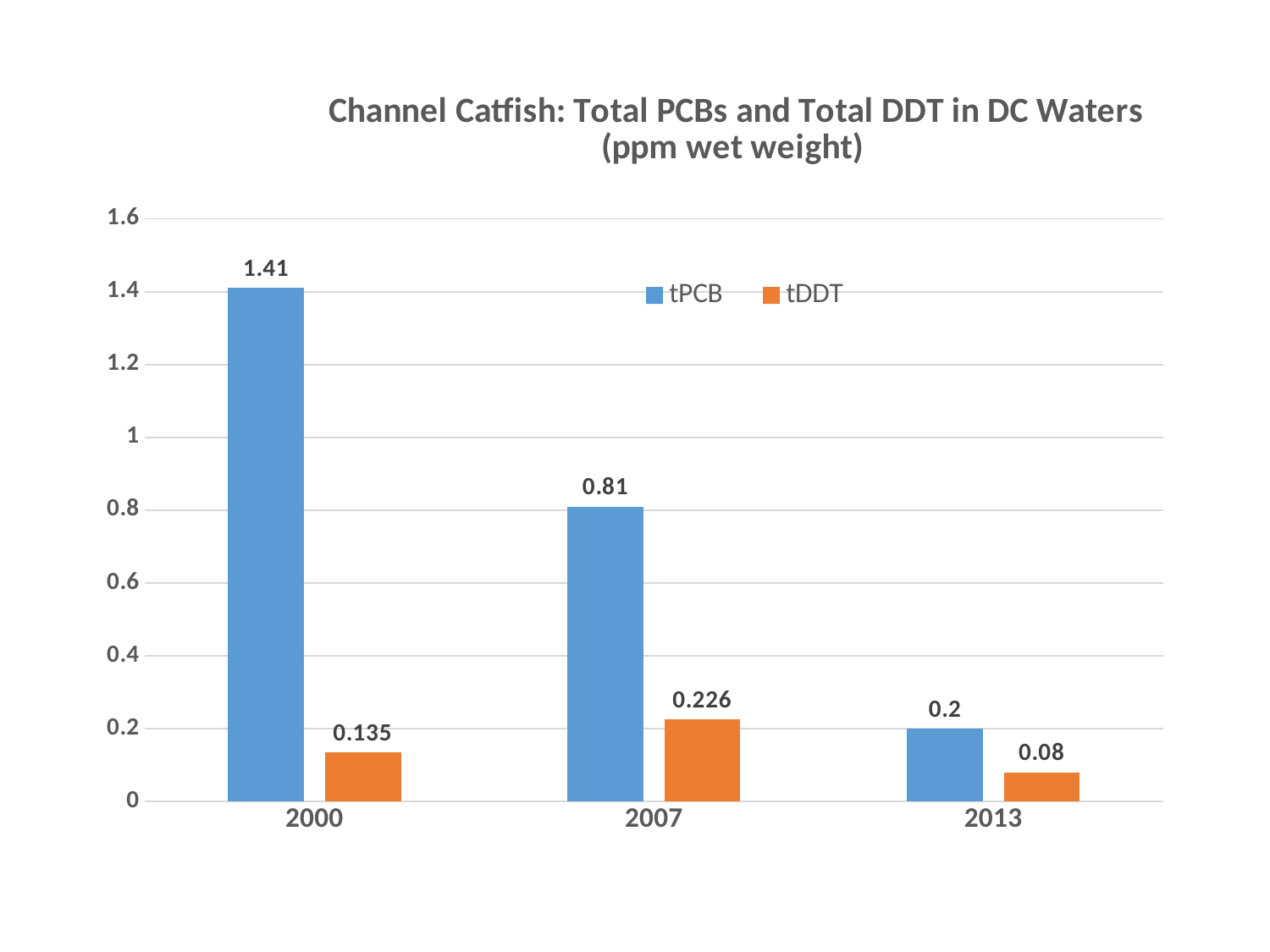
How many series does the legend list? 2 What is the tPCB value for 2000? 1.41 Which is larger, the tPCB value for 2013 or the tDDT value for 2007? tDDT value for 2007 What is the difference between the tPCB values for 2000 and 2007? 0.6 What is the tDDT value for 2013? 0.08 Which year has the lowest tDDT value? 2013 Is the tPCB value for 2007 greater or less than 1? less What is the difference between the tDDT values for 2007 and 2000? 0.091 What is the tDDT value for 2007? 0.226 How many years are shown on the x axis? 3 What kind of chart is shown on the slide? bar chart Which year has the highest tPCB value? 2000